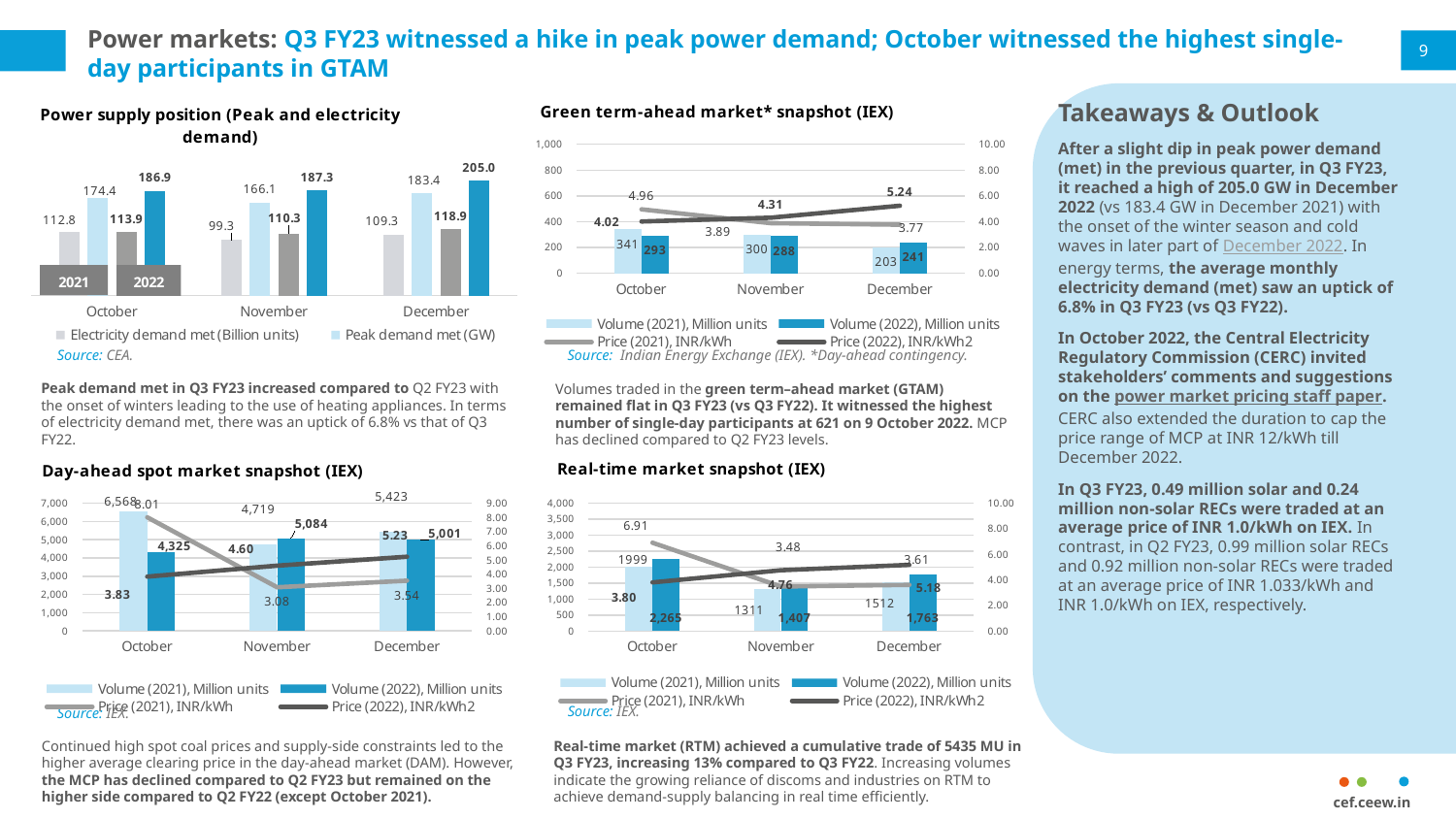
In the 'Power supply position (Peak and electricity demand)' chart, what is the difference between peak demand met in December 2022 and December 2021? 21.6 In the 'Green term-ahead market* snapshot (IEX)' chart, what is the Volume (2021), Million units for October? 341 In the 'Real-time market snapshot (IEX)' chart, does the Price (2022), INR/kWh rise or fall from October to December? rise In the 'Day-ahead spot market snapshot (IEX)' chart, what is the Volume (2022), Million units for November? 5,084 In the 'Power supply position (Peak and electricity demand)' chart, what is the electricity demand met (Billion units) for November 2021? 99.3 In the 'Day-ahead spot market snapshot (IEX)' chart, which month has the lowest Price (2021), INR/kWh? November In the 'Power supply position (Peak and electricity demand)' chart, what is the peak demand met (GW) for December 2022? 205.0 In the 'Real-time market snapshot (IEX)' chart, what is the Price (2021), INR/kWh for October? 6.91 In the 'Day-ahead spot market snapshot (IEX)' chart, is the Volume (2021) for October larger or smaller than the Volume (2022) for October? larger In the 'Green term-ahead market* snapshot (IEX)' chart, how many series does the legend list? 4 How many months are shown on the x axis of the 'Real-time market snapshot (IEX)' chart? 3 In the 'Green term-ahead market* snapshot (IEX)' chart, which month has the highest Price (2022), INR/kWh? December